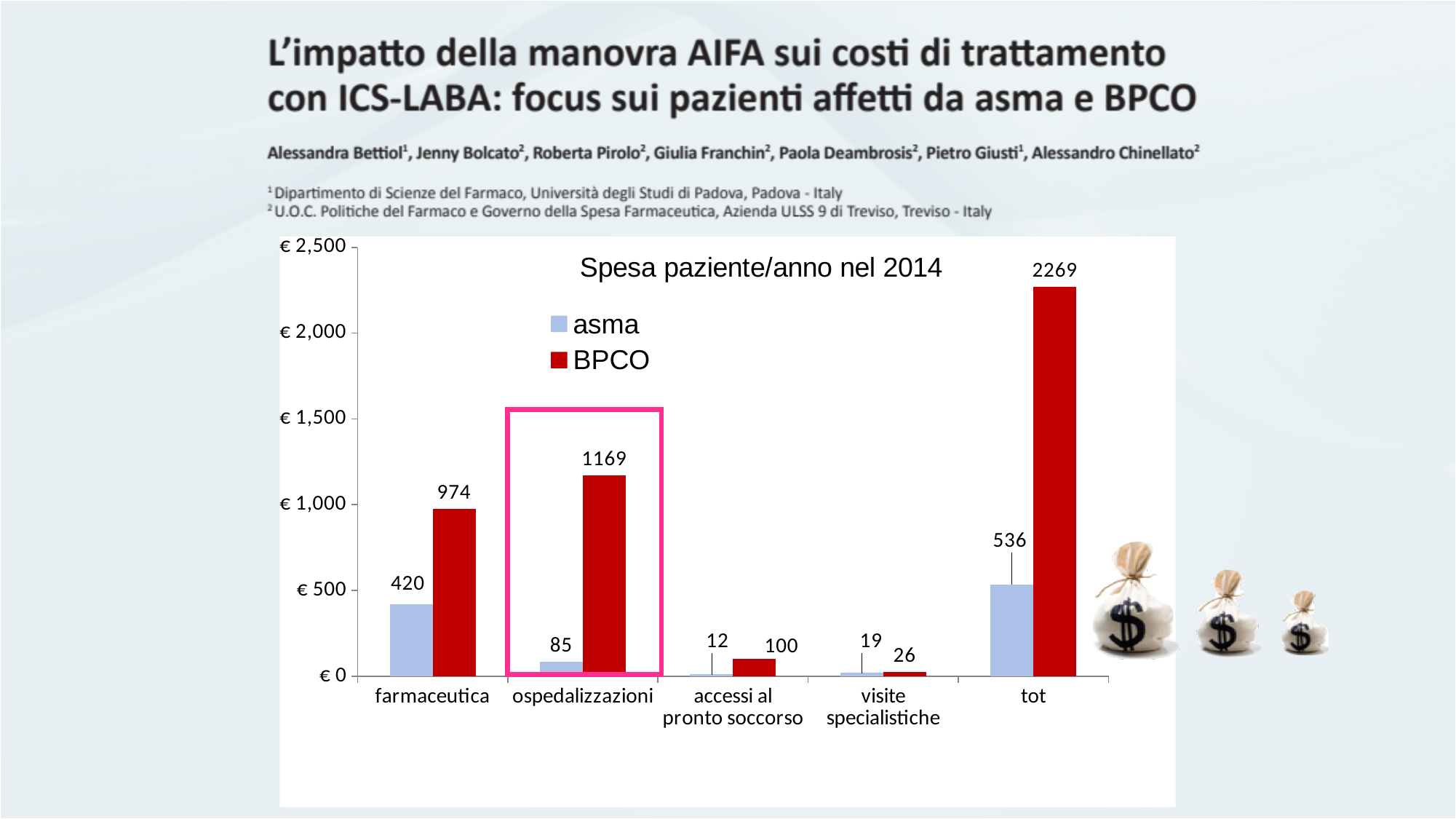
Which category has the lowest asma value? accessi al pronto soccorso How many categories are shown on the x axis? 5 What is the asma value for visite specialistiche? 19 What is the asma value for farmaceutica? 420 What is the title of the chart? Spesa paziente/anno nel 2014 What is the difference between the BPCO and asma values for farmaceutica? 554 What kind of chart is shown? bar chart What is the BPCO value for ospedalizzazioni? 1169 How many series does the legend list? 2 Which category has the highest BPCO value? tot What is the BPCO value for tot? 2269 Which is larger for ospedalizzazioni, the asma value or the BPCO value? BPCO